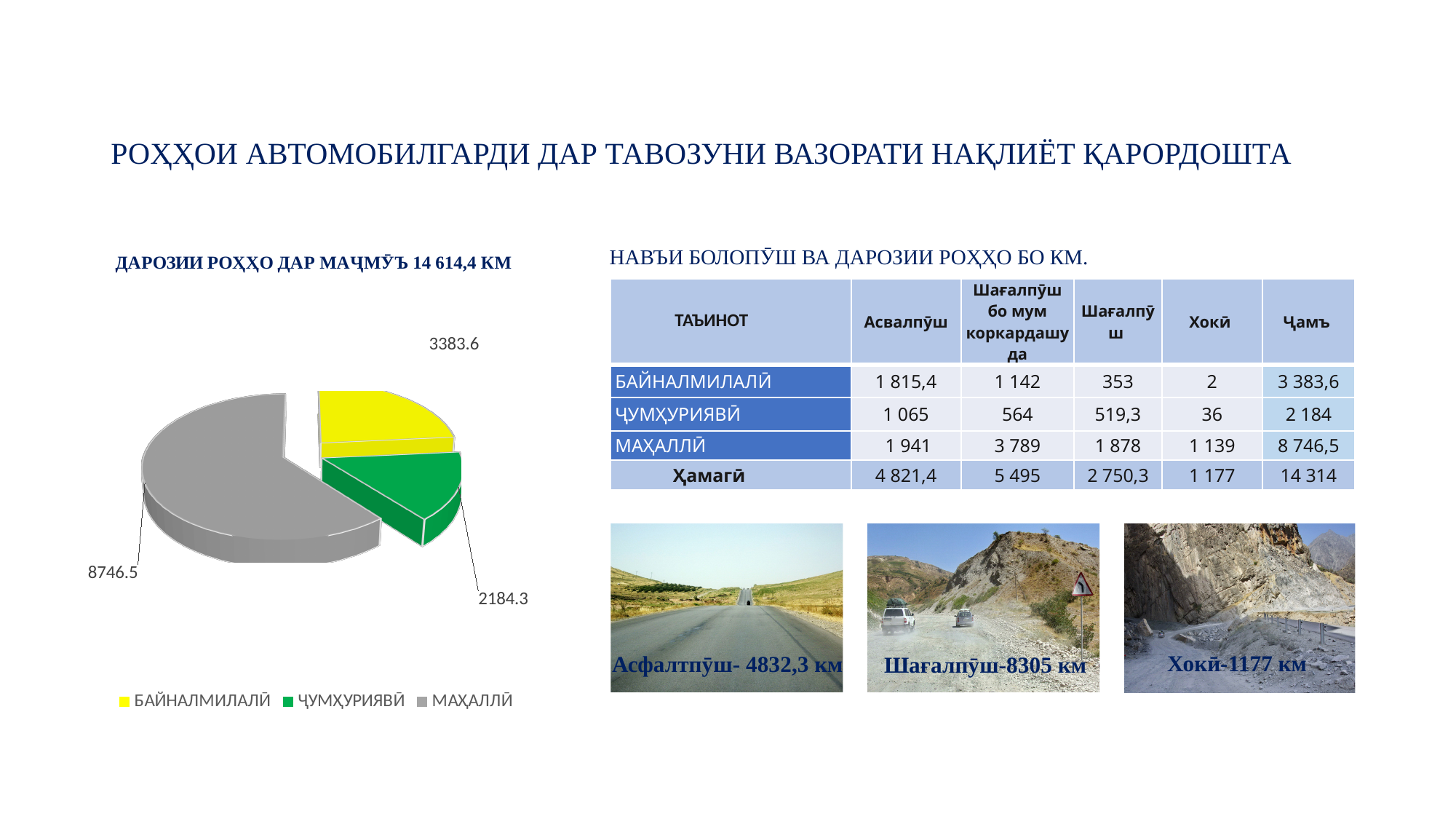
What is the difference between the values for МАҲАЛЛӢ and БАЙНАЛМИЛАЛӢ in the pie chart? 5362.9 Which category has the smallest slice in the pie chart? ҶУМҲУРИЯВӢ Which is larger in the pie chart, БАЙНАЛМИЛАЛӢ or ҶУМҲУРИЯВӢ? БАЙНАЛМИЛАЛӢ What is the value for ҶУМҲУРИЯВӢ in the pie chart? 2184.3 Which colour represents ҶУМҲУРИЯВӢ in the pie chart legend? Green What is the title of the pie chart? ДАРОЗИИ РОҲҲО ДАР МАҶМӮЪ 14 614,4 КМ How many slices does the pie chart have? 3 Which category has the largest slice in the pie chart? МАҲАЛЛӢ What is the difference between the values for БАЙНАЛМИЛАЛӢ and ҶУМҲУРИЯВӢ in the pie chart? 1199.3 What is the value for БАЙНАЛМИЛАЛӢ in the pie chart? 3383.6 What is the value for МАҲАЛЛӢ in the pie chart? 8746.5 What kind of chart is shown on the slide? Pie chart